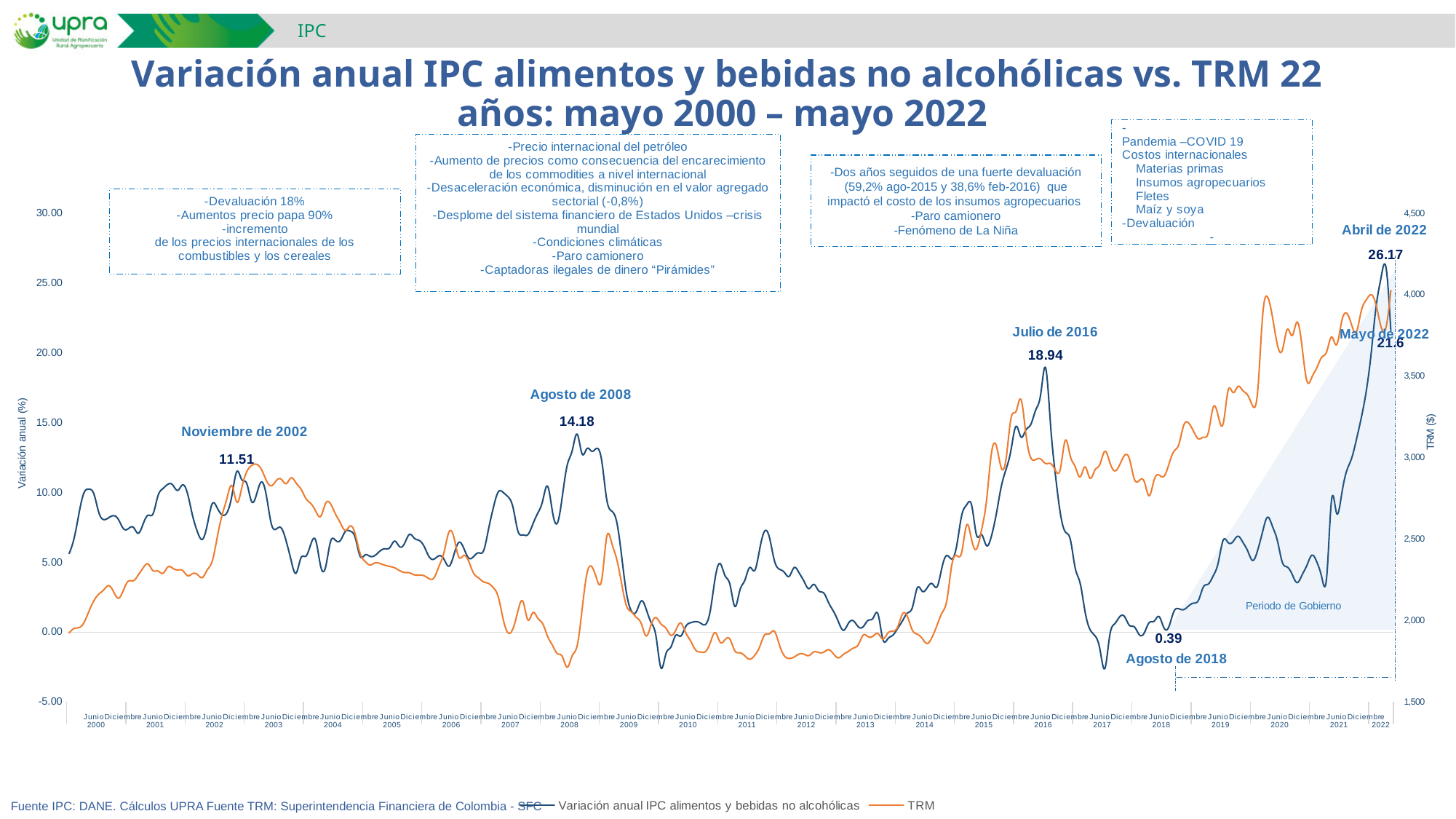
What kind of chart is shown on the slide? line chart Which labelled point on the IPC line has the lowest value? Agosto de 2018 How many series does the legend list? 2 Which series is drawn in orange according to the legend? TRM What is the labelled value of the annual food IPC variation for Noviembre de 2002? 11.51 What is the difference between the labelled IPC values for Abril de 2022 and Julio de 2016? 7.23 Which labelled point on the IPC line has the highest value? Abril de 2022 What is the labelled value of the annual food IPC variation for Abril de 2022? 26.17 What is the labelled value of the annual food IPC variation for Julio de 2016? 18.94 What is the labelled value of the annual food IPC variation for Agosto de 2018? 0.39 Which labelled IPC value is larger, Agosto de 2008 or Noviembre de 2002? Agosto de 2008 What is the labelled value of the annual food IPC variation for Agosto de 2008? 14.18